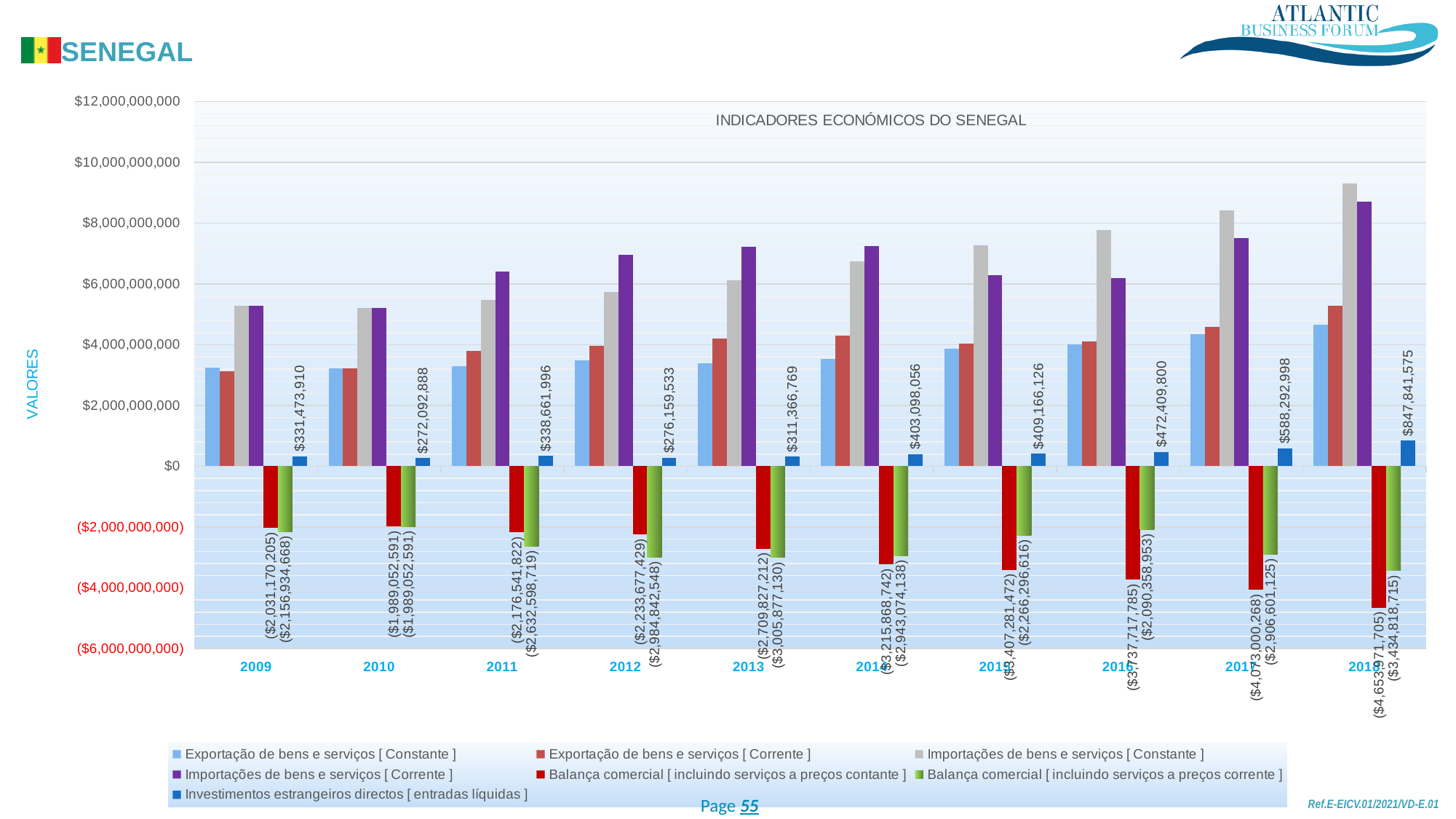
What type of chart is shown on the slide? Bar chart What is the value of Investimentos estrangeiros directos [ entradas líquidas ] in 2009? $331,473,910 What is the value of Balança comercial [ incluindo serviços a preços corrente ] in 2012? ($2,984,842,548) Is the value of Importações de bens e serviços [ Corrente ] in 2018 greater or less than $8,000,000,000? greater What is the difference between Investimentos estrangeiros directos [ entradas líquidas ] in 2018 and in 2017? $259,548,577 Is the value of Exportação de bens e serviços [ Constante ] in 2009 greater or less than $4,000,000,000? less How many years are shown on the x axis of the chart? 10 In which year is Investimentos estrangeiros directos [ entradas líquidas ] highest? 2018 What is the value of Investimentos estrangeiros directos [ entradas líquidas ] in 2018? $847,841,575 In which year is Investimentos estrangeiros directos [ entradas líquidas ] lowest? 2010 How many series does the chart's legend list? 7 What is the title of the chart? INDICADORES ECONÓMICOS DO SENEGAL